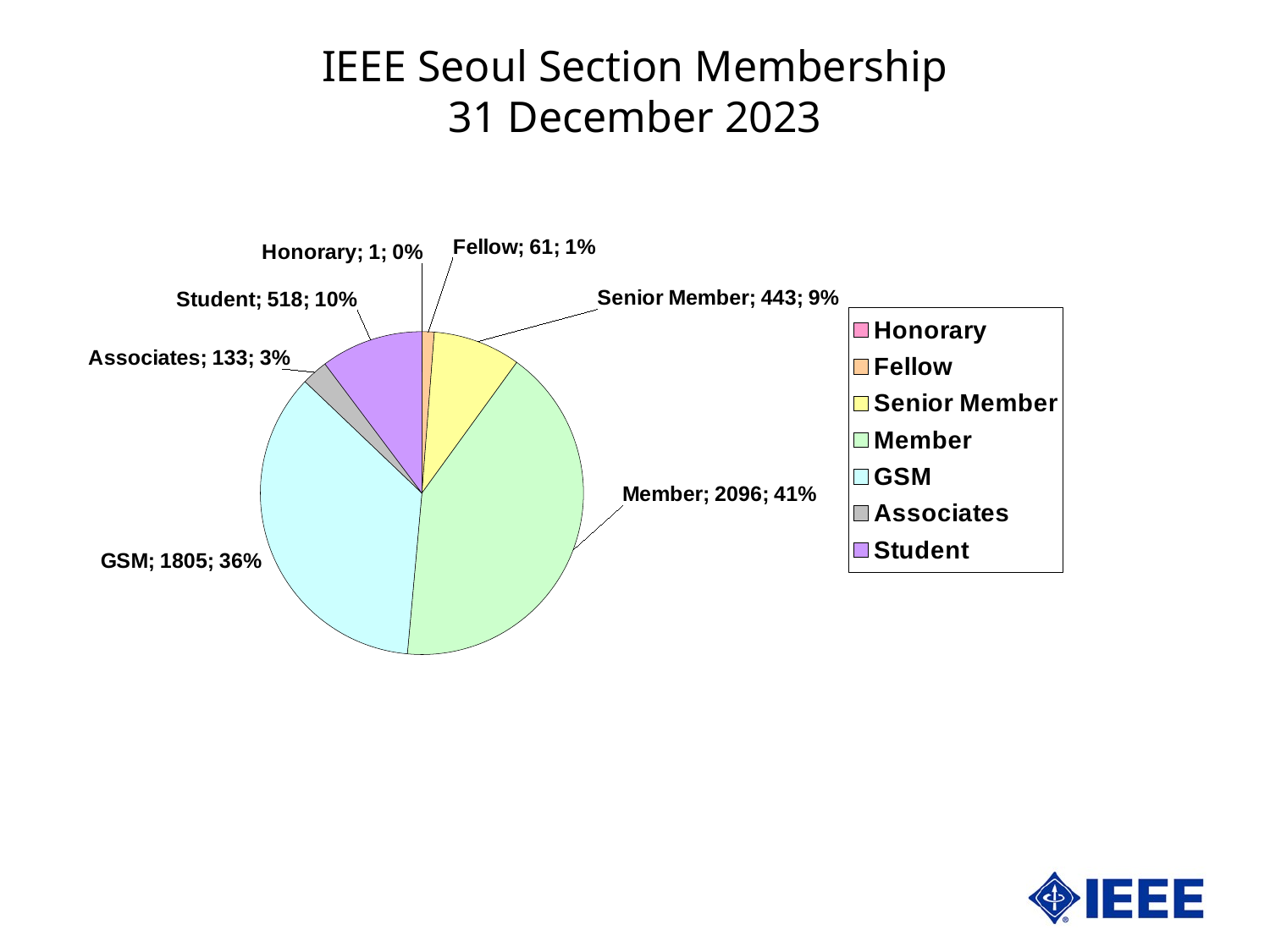
What is the title of the chart? IEEE Seoul Section Membership 31 December 2023 Which category has the largest slice of the pie? Member How many members are in the Member category? 2096 How many Senior Members are shown? 443 What is the value shown for GSM? 1805 Which is larger, Student or Senior Member? Student What kind of chart is shown on the slide? Pie chart What share of the pie does GSM represent? 36% What share of the pie does Associates represent? 3% What is the difference between the Member and GSM values? 291 Which category has the smallest slice of the pie? Honorary How many categories does the pie chart show? 7